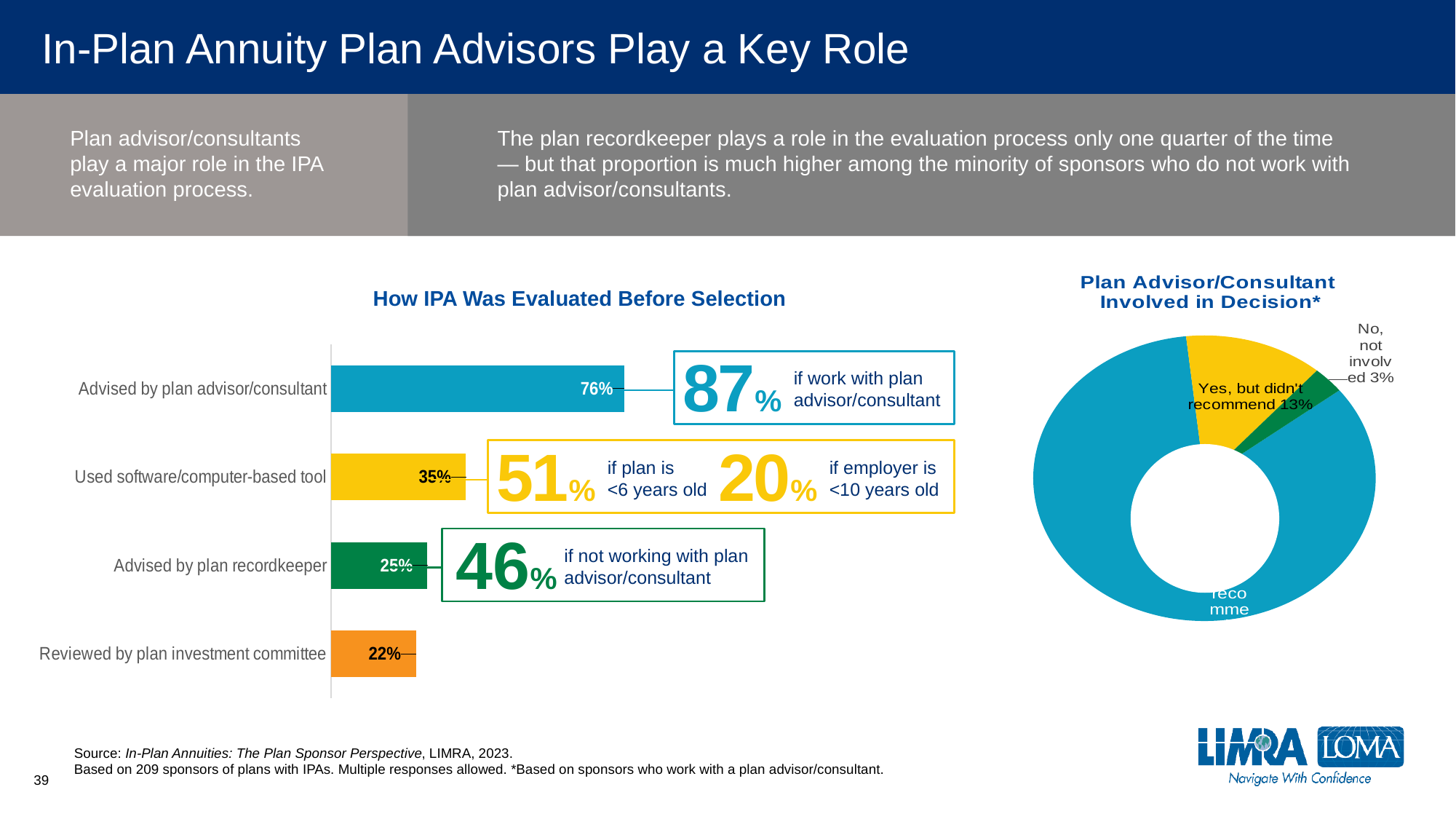
How many categories are shown in the 'How IPA Was Evaluated Before Selection' chart? 4 In the 'How IPA Was Evaluated Before Selection' chart, what is the difference between 'Advised by plan advisor/consultant' and 'Used software/computer-based tool'? 41% What kind of chart is 'How IPA Was Evaluated Before Selection'? Bar chart In the 'How IPA Was Evaluated Before Selection' chart, what is the value for 'Used software/computer-based tool'? 35% In the 'How IPA Was Evaluated Before Selection' chart, what is the value for 'Advised by plan advisor/consultant'? 76% In the 'Plan Advisor/Consultant Involved in Decision*' chart, what share is 'Yes, but didn't recommend'? 13% In the 'Plan Advisor/Consultant Involved in Decision*' chart, what share is 'No, not involved'? 3% In the 'How IPA Was Evaluated Before Selection' chart, which is larger: 'Advised by plan recordkeeper' or 'Reviewed by plan investment committee'? Advised by plan recordkeeper In the 'How IPA Was Evaluated Before Selection' chart, which category has the lowest value? Reviewed by plan investment committee In the 'How IPA Was Evaluated Before Selection' chart, which category has the highest value? Advised by plan advisor/consultant In the 'How IPA Was Evaluated Before Selection' chart, what is the value for 'Advised by plan recordkeeper'? 25% In the 'How IPA Was Evaluated Before Selection' chart, what is the value for 'Reviewed by plan investment committee'? 22%